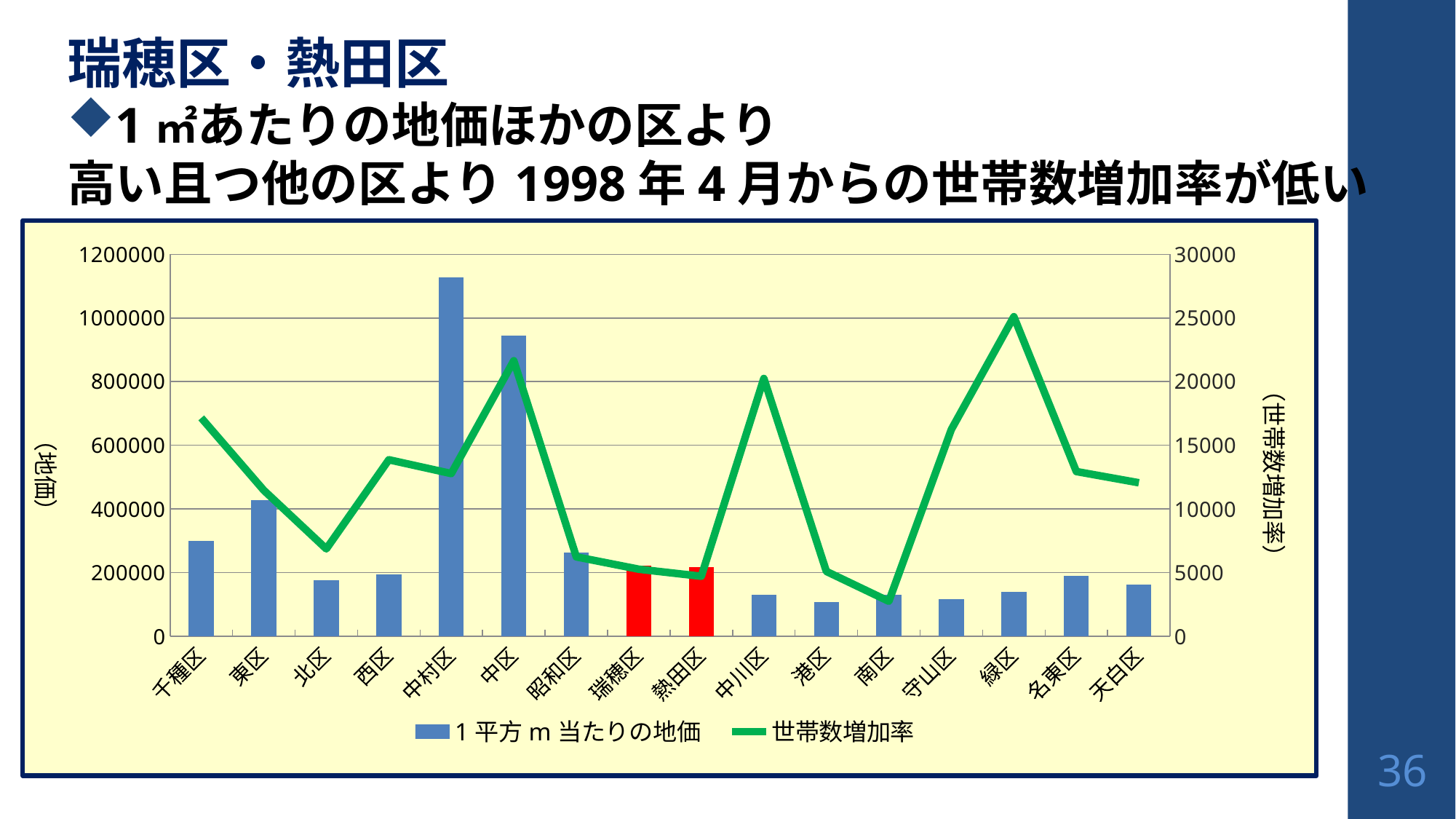
How many series does the legend list? 2 Which ward has the highest bar for 1平方m当たりの地価? 中村区 What kind of chart is shown on the slide? A combination bar and line chart Which two wards have their bars highlighted in red? 瑞穂区 and 熱田区 How many wards (categories) are shown on the x axis? 16 Is the 世帯数増加率 value for 緑区 greater or less than 20000? greater Which ward has the larger 1平方m当たりの地価 bar, 千種区 or 東区? 東区 Is the 世帯数増加率 value for 南区 greater or less than 5000? less Is the 1平方m当たりの地価 bar for 中区 greater or less than 1000000? less Which ward has the highest point on the 世帯数増加率 line? 緑区 Which ward has the lowest point on the 世帯数増加率 line? 南区